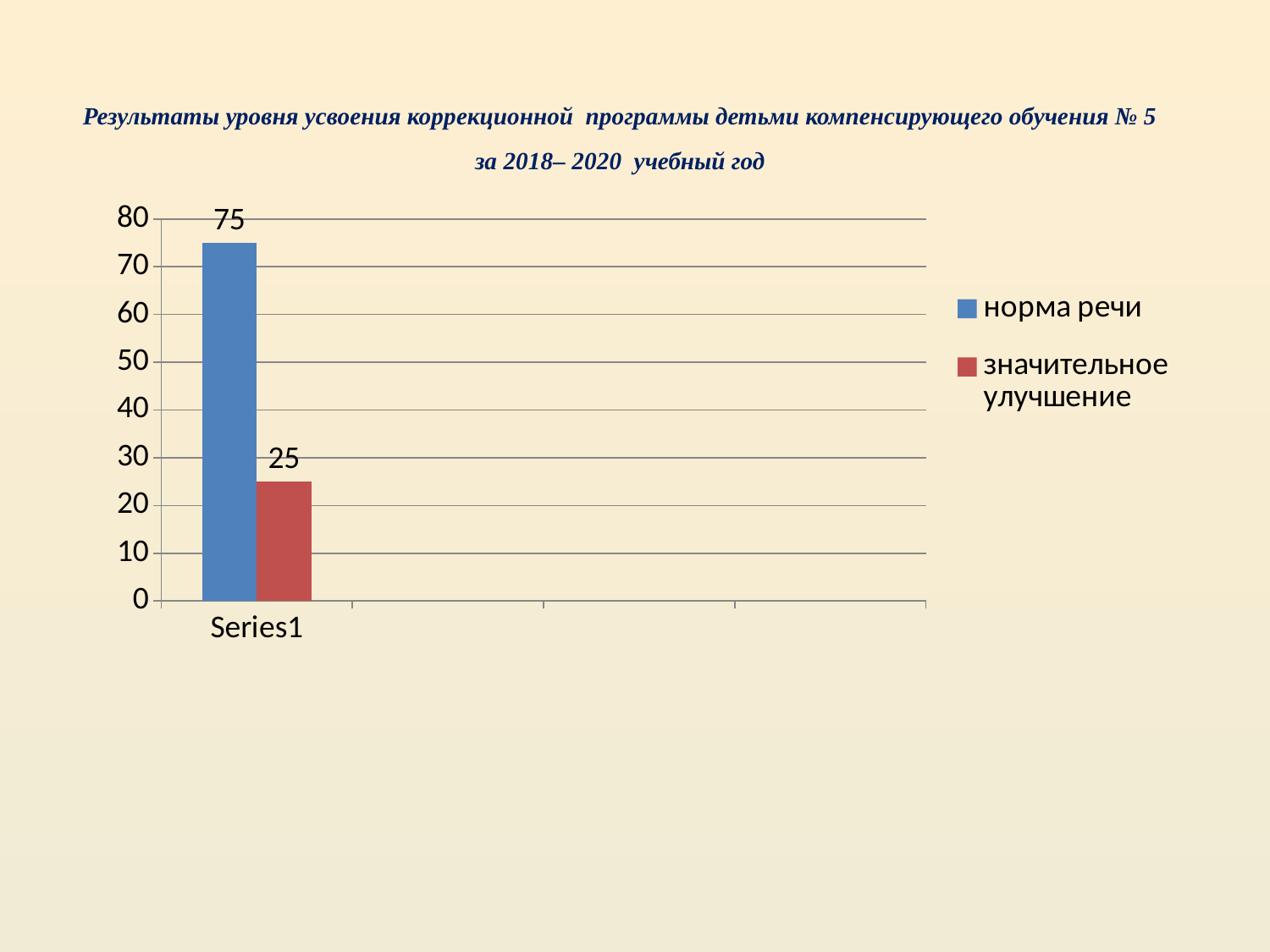
What is the value for "значительное улучшение"? 25 What kind of chart is shown on the slide? bar chart What is the value for "норма речи"? 75 Which series has the highest value? норма речи Which is larger, the value for "норма речи" or for "значительное улучшение"? норма речи How many series does the legend list? 2 What colour is the bar for "значительное улучшение"? red Is the value for "норма речи" greater or less than 70? greater Which series has the lowest value? значительное улучшение What is the difference between the values for "норма речи" and "значительное улучшение"? 50 Is the value for "значительное улучшение" greater or less than 30? less What is the category label shown on the x axis? Series1